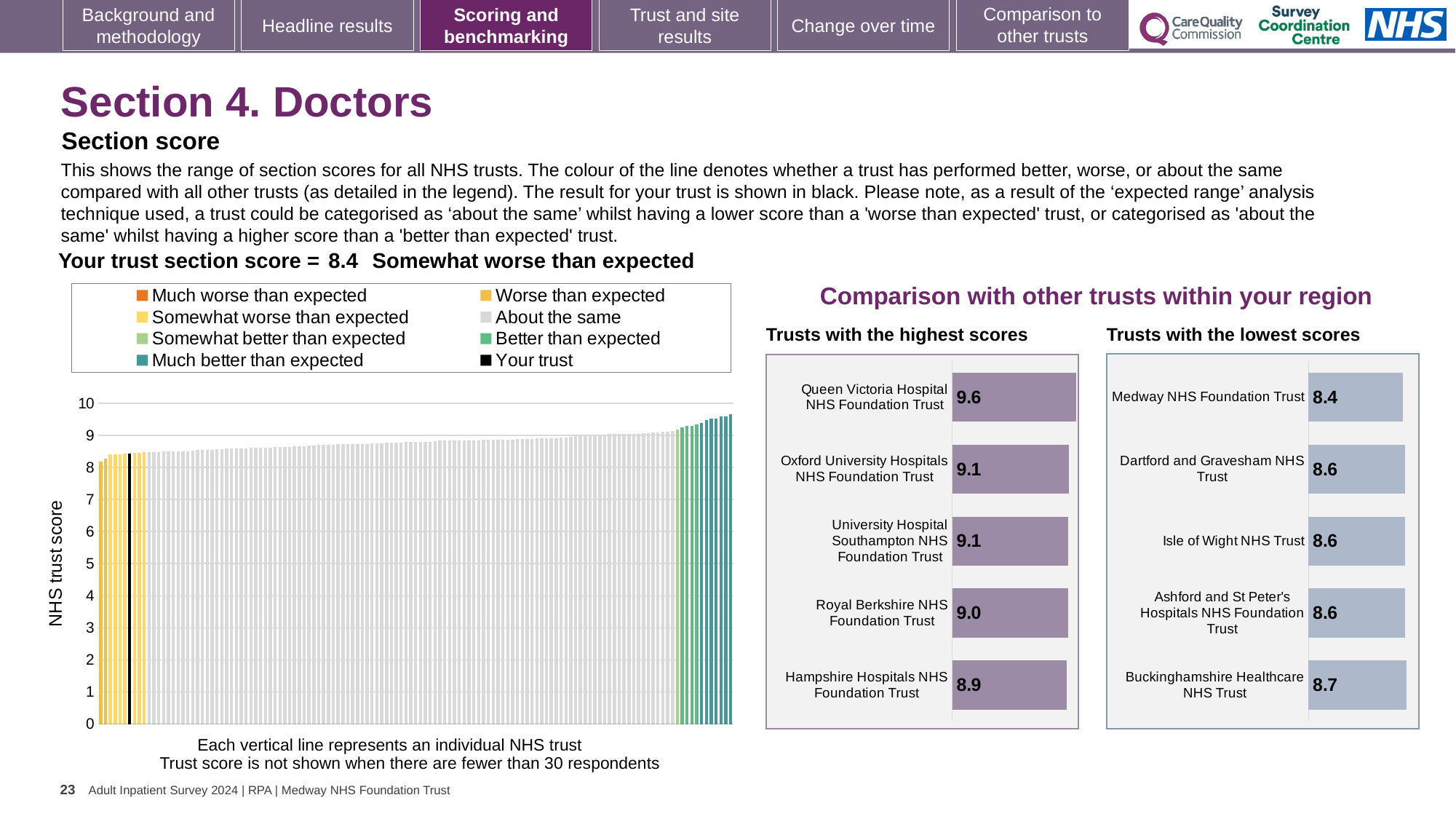
Which is larger: the score for Royal Berkshire NHS Foundation Trust in the 'Trusts with the highest scores' chart or the score for Buckinghamshire Healthcare NHS Trust in the 'Trusts with the lowest scores' chart? Royal Berkshire NHS Foundation Trust What kind of chart is the 'Trusts with the lowest scores' chart? Bar chart In the 'Trusts with the highest scores' chart, what is the score for Queen Victoria Hospital NHS Foundation Trust? 9.6 How many entries does the legend of the main NHS trust score chart on the left list? 8 In the main NHS trust score chart on the left, do the bar values rise or fall from left to right? Rise In the 'Trusts with the lowest scores' chart, which trust has the lowest score? Medway NHS Foundation Trust In the 'Trusts with the lowest scores' chart, what is the difference between the scores of Buckinghamshire Healthcare NHS Trust and Medway NHS Foundation Trust? 0.3 In the 'Trusts with the lowest scores' chart, what is the score for Medway NHS Foundation Trust? 8.4 In the 'Trusts with the highest scores' chart, which trust has the highest score? Queen Victoria Hospital NHS Foundation Trust In the 'Trusts with the highest scores' chart, what is the difference between the scores of Queen Victoria Hospital NHS Foundation Trust and Hampshire Hospitals NHS Foundation Trust? 0.7 How many trusts are shown in the 'Trusts with the highest scores' chart? 5 What is the y-axis label of the main NHS trust score chart on the left? NHS trust score